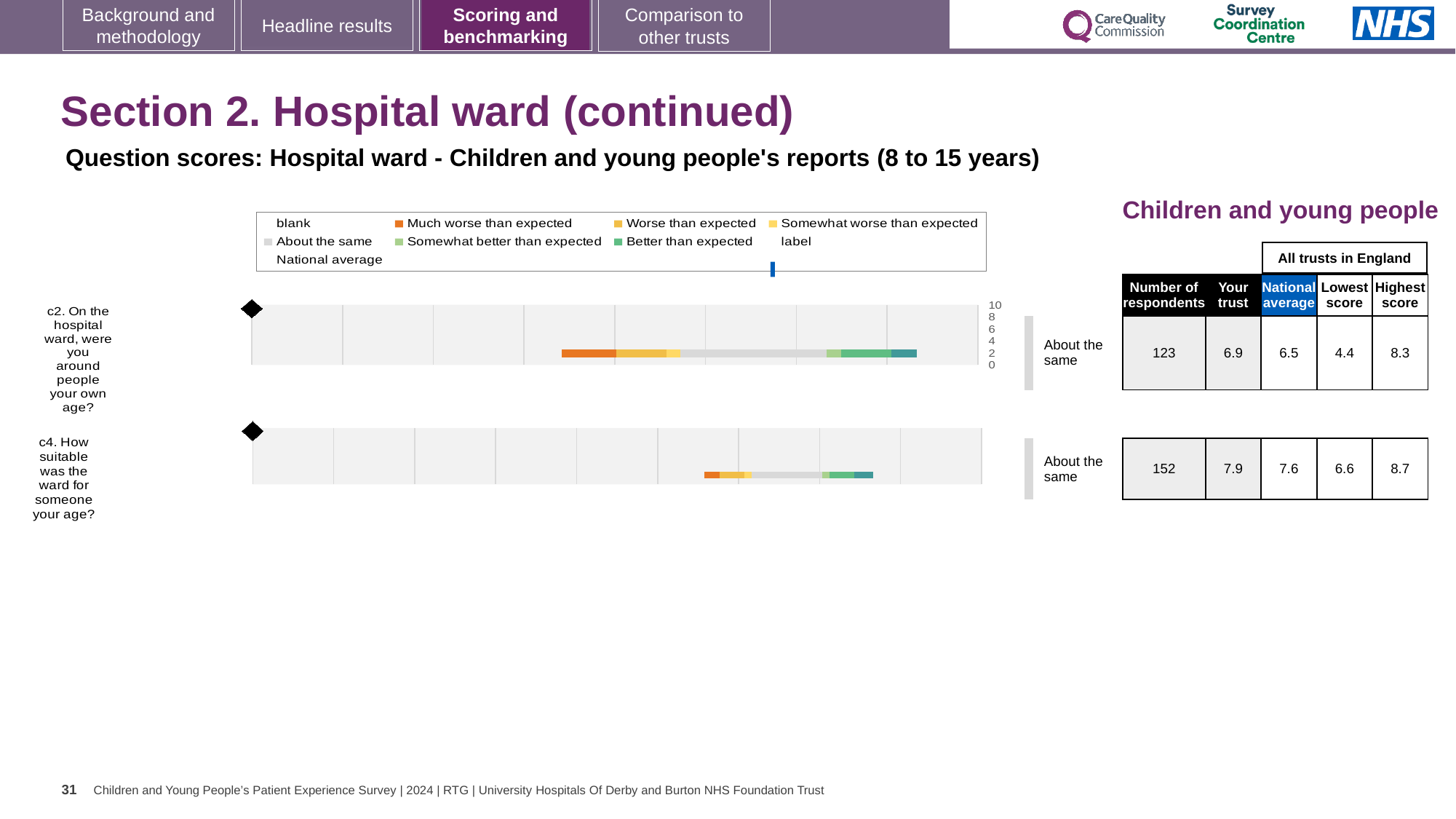
How many respondents answered question c4? 152 What kind of chart is used to show the question scores on this slide? Bar chart What benchmark category label is shown next to the chart for question c2? About the same What is the highest score across all trusts in England for question c2? 8.3 For question c4, what is the difference between the highest score and the lowest score across all trusts in England? 2.1 What is the lowest score across all trusts in England for question c4? 6.6 How many questions are charted on this slide? 2 Which question has the higher 'Your trust' score, c2 or c4? c4 For question c2, how much higher is the trust's score than the national average? 0.4 What is the 'Your trust' score for question c2 (On the hospital ward, were you around people your own age?)? 6.9 What is the 'Your trust' score for question c4 (How suitable was the ward for someone your age?)? 7.9 What is the national average score for question c2? 6.5